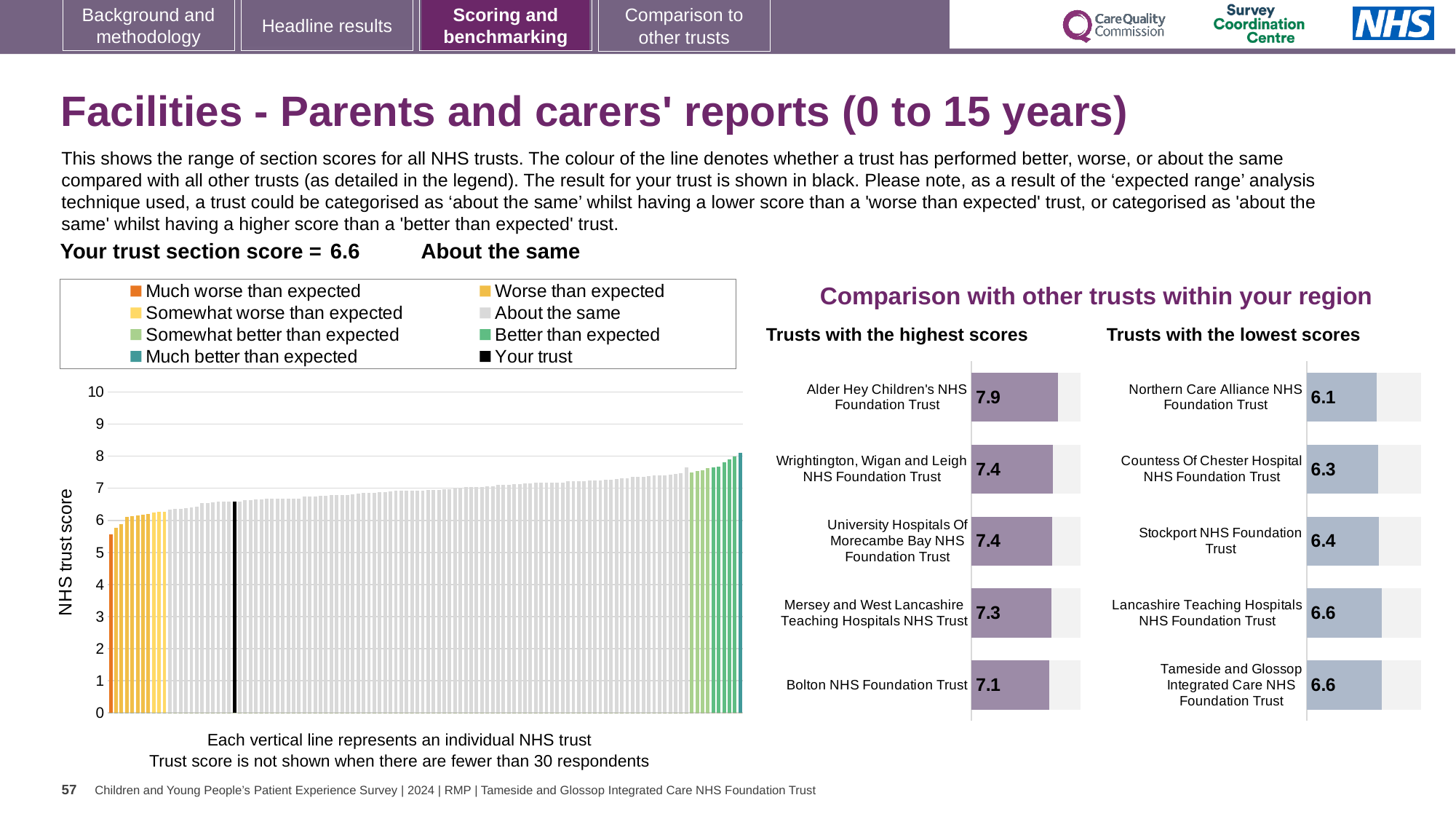
In the 'Trusts with the lowest scores' chart, what is the difference between the scores of Stockport NHS Foundation Trust and Northern Care Alliance NHS Foundation Trust? 0.3 In the 'Trusts with the lowest scores' chart, which trust has the lowest score? Northern Care Alliance NHS Foundation Trust In the main 'NHS trust score' chart on the left, do the trust scores rise or fall from left to right? rise In the 'Trusts with the highest scores' chart, what is the score for Bolton NHS Foundation Trust? 7.1 In the 'Trusts with the highest scores' chart, which trust has the highest score? Alder Hey Children's NHS Foundation Trust In the main 'NHS trust score' chart on the left, is the value for the black 'Your trust' bar greater or less than 7? less In the 'Trusts with the highest scores' chart, what is the difference between the scores of Alder Hey Children's NHS Foundation Trust and Bolton NHS Foundation Trust? 0.8 In the 'Trusts with the highest scores' chart, what is the score for Alder Hey Children's NHS Foundation Trust? 7.9 In the 'Trusts with the lowest scores' chart, what is the score for Stockport NHS Foundation Trust? 6.4 How many trusts are listed in the 'Trusts with the highest scores' chart? 5 In the 'Trusts with the lowest scores' chart, what is the score for Northern Care Alliance NHS Foundation Trust? 6.1 Which has the higher score: Mersey and West Lancashire Teaching Hospitals NHS Trust in the highest-scores chart or Countess Of Chester Hospital NHS Foundation Trust in the lowest-scores chart? Mersey and West Lancashire Teaching Hospitals NHS Trust